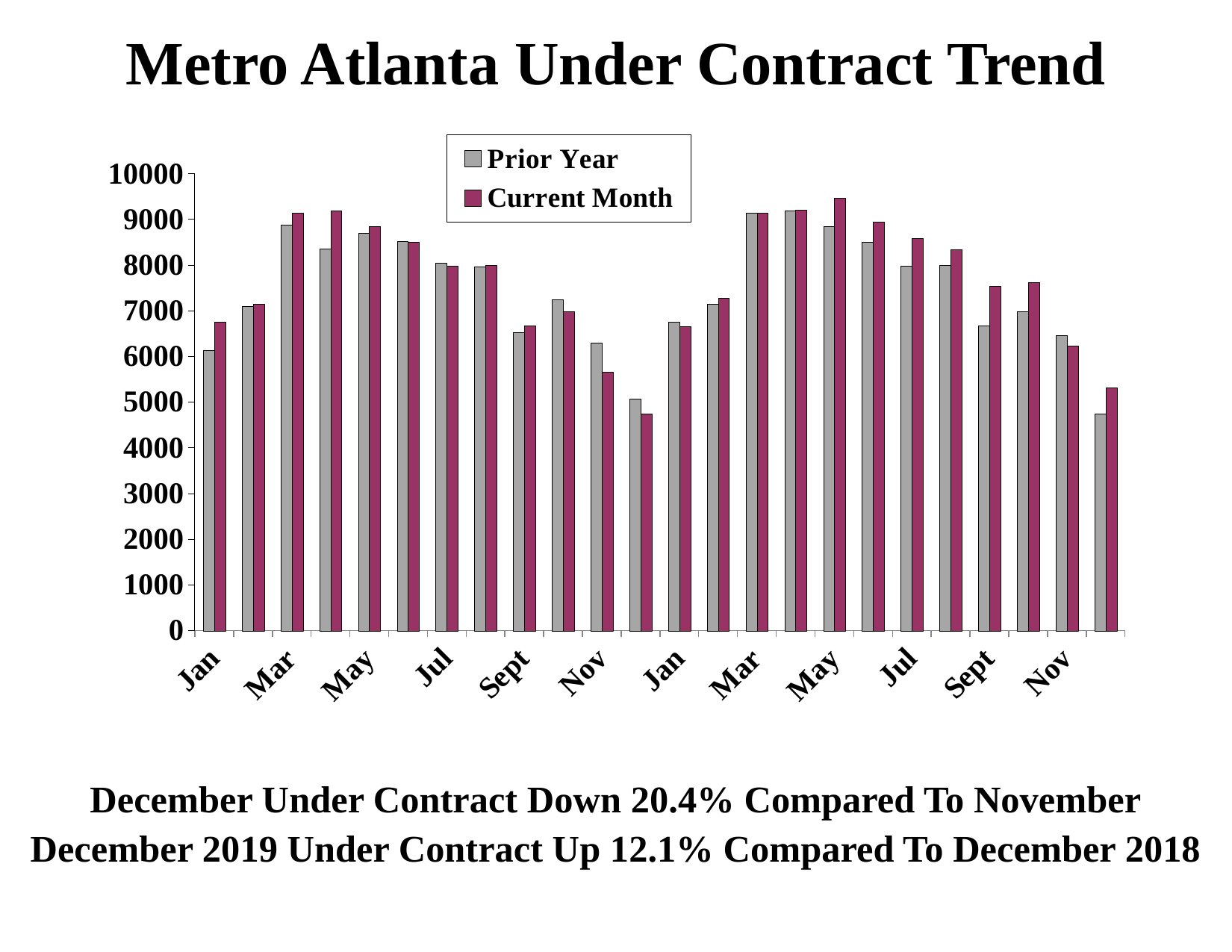
How many month labels appear along the x axis? 12 What is the title of the chart? Metro Atlanta Under Contract Trend From the first May to the first Jul, do the Current Month bars rise or fall? fall For the second May, which is larger: Prior Year or Current Month? Current Month Is the Prior Year value for the first Jan greater or less than 5000? greater Is the Current Month value for the first Jan greater or less than 6000? greater For the first Nov, which is larger: Prior Year or Current Month? Prior Year How many series does the legend list? 2 Is the Current Month value for the second Sept greater or less than 7000? greater Which series is shown in the darker (maroon) colour? Current Month What kind of chart is shown on the slide? bar chart